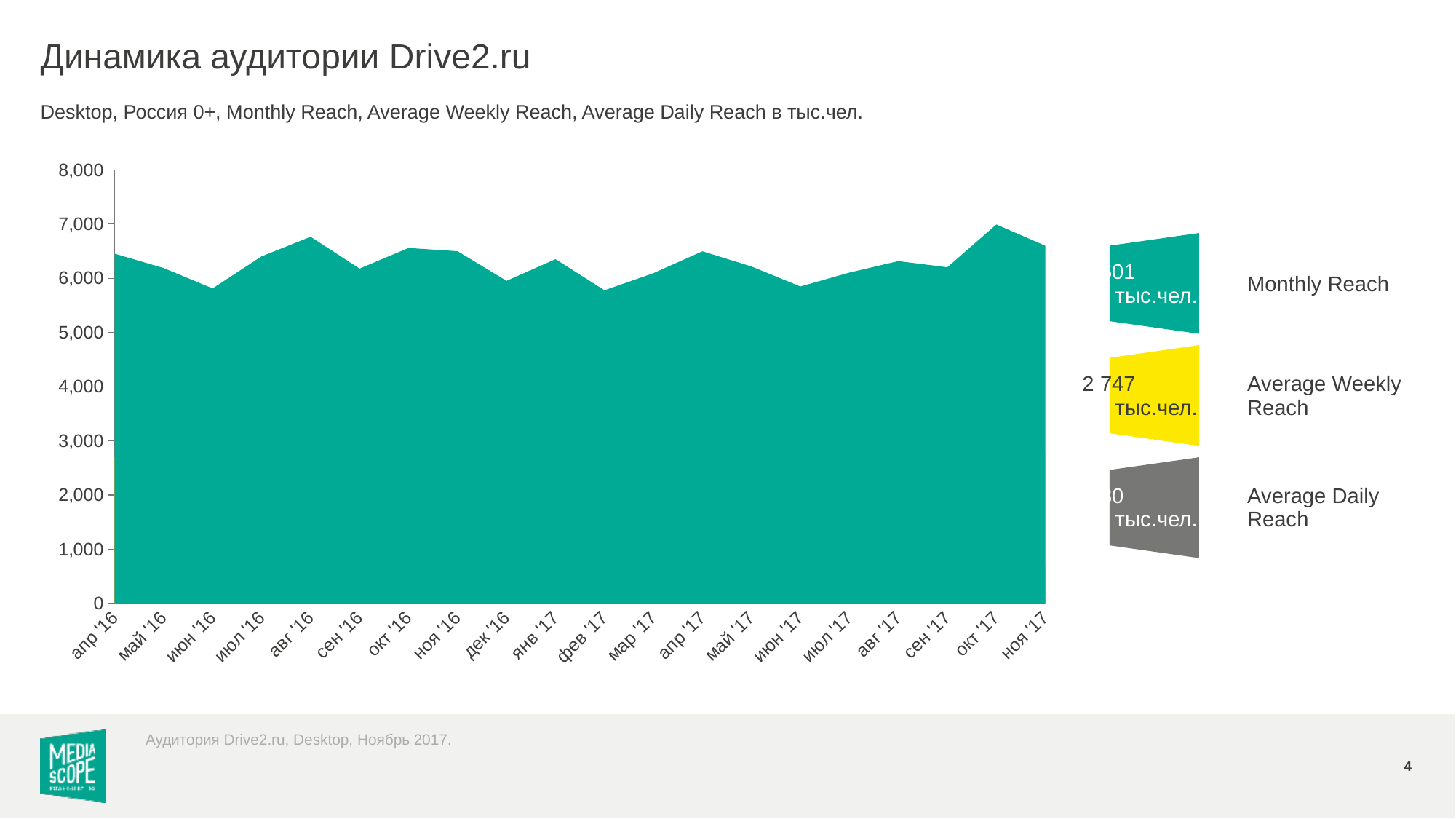
Is the Monthly Reach for окт '17 greater or less than 6,500? greater Is the Monthly Reach for июн '16 greater or less than 6,000? less Which month has the highest Monthly Reach in the chart? окт '17 Is the Monthly Reach for фев '17 greater or less than 6,000? less Which is larger, the Monthly Reach for окт '17 or for сен '17? окт '17 What is the Average Weekly Reach value shown next to the chart? 2 747 тыс.чел. What is the title of the slide containing the chart? Динамика аудитории Drive2.ru What kind of chart is shown on the slide? area chart Does the Monthly Reach rise or fall from сен '17 to окт '17? rise How many months are plotted along the x axis of the chart? 20